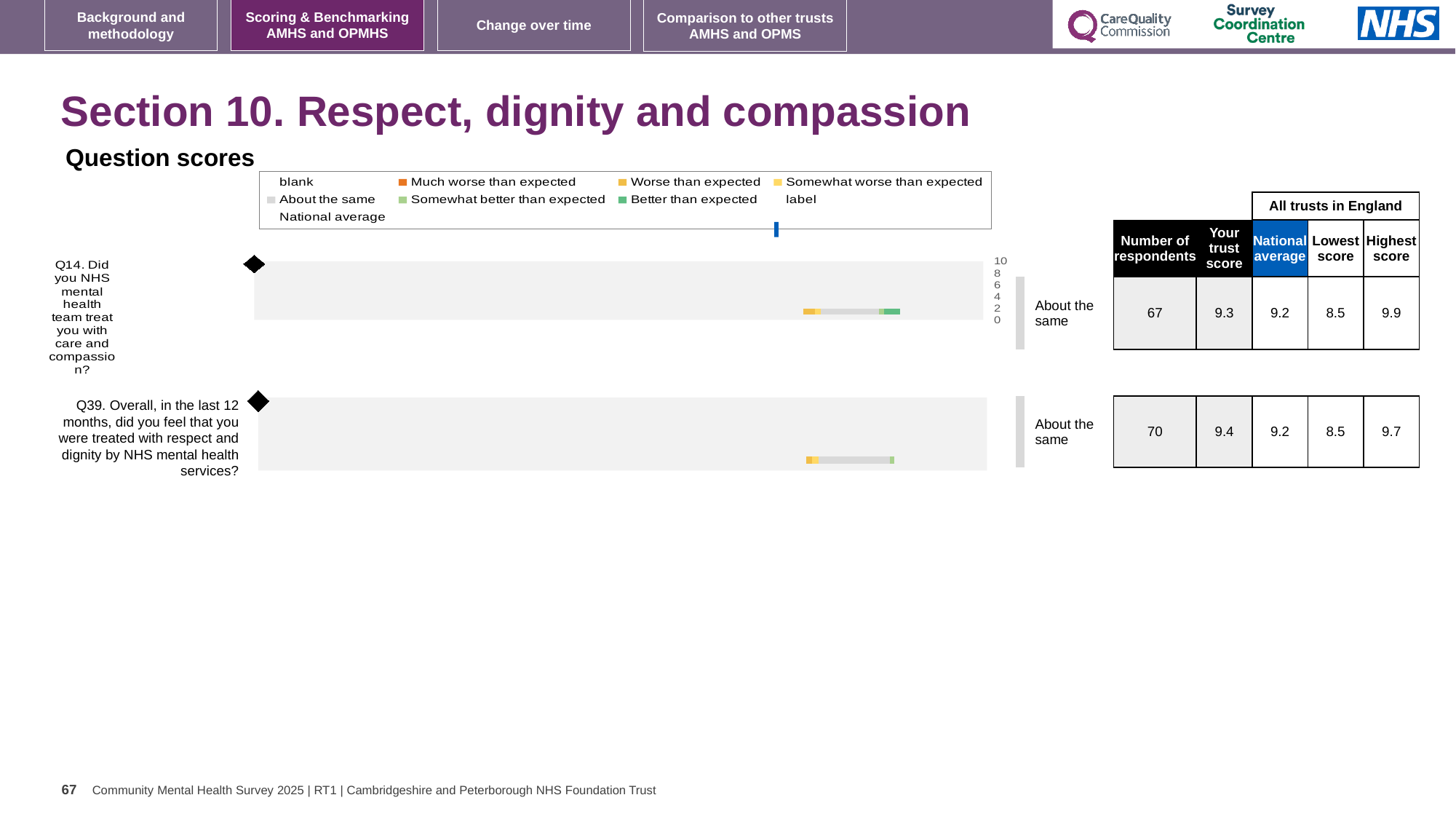
How many respondents answered Q39? 70 Which question has the higher trust score, Q14 or Q39? Q39 What is the trust score for Q14 (care and compassion)? 9.3 What kind of chart is used to show the question scores on this slide? bar chart What benchmark category label is shown next to both Q14 and Q39 in the chart? About the same What is the highest score among all trusts in England for Q14? 9.9 How many respondents answered Q14? 67 What is the national average score for Q14? 9.2 How many questions are plotted in the question scores chart? 2 What is the difference between the trust score and the national average for Q14? 0.1 What is the trust score for Q39 (respect and dignity)? 9.4 What is the difference between the highest and lowest scores for Q39? 1.2